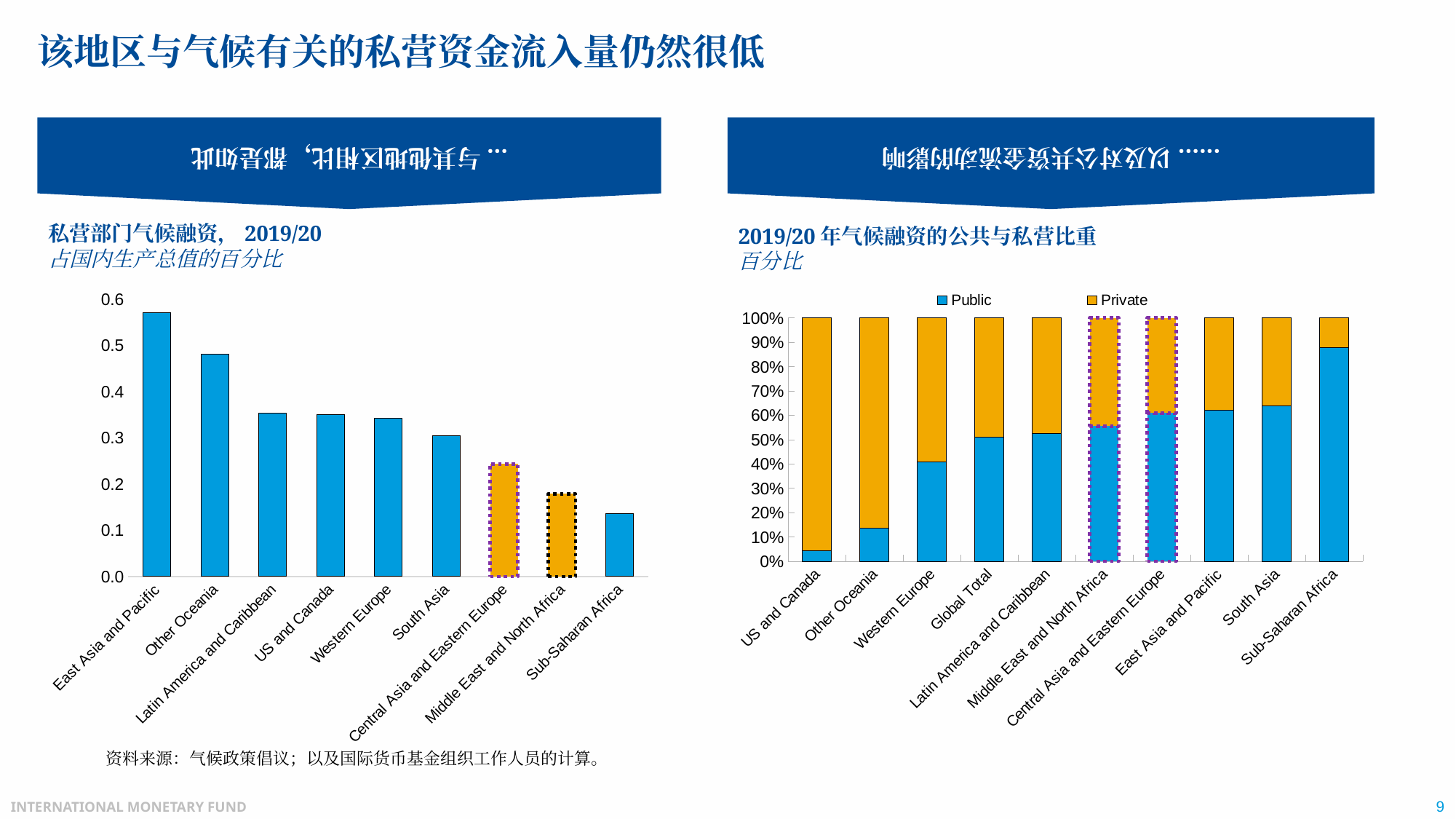
In the left chart (私营部门气候融资，2019/20), which region has the highest value? East Asia and Pacific In the right chart (2019/20 年气候融资的公共与私营比重), how many series does the legend list? 2 In the left chart (私营部门气候融资，2019/20), is the value for Other Oceania greater or less than 0.4? greater In the right chart (2019/20 年气候融资的公共与私营比重), which region has the largest Public share? Sub-Saharan Africa In the right chart (2019/20 年气候融资的公共与私营比重), which colour represents the Private series? orange In the left chart (私营部门气候融资，2019/20), do the values rise or fall from left to right across the regions? fall In the left chart (私营部门气候融资，2019/20), how many regions are shown? 9 What kind of chart is the left chart titled 私营部门气候融资，2019/20? bar chart In the right chart (2019/20 年气候融资的公共与私营比重), how many regions are shown on the x axis? 10 In the left chart (私营部门气候融资，2019/20), which region has the lowest value? Sub-Saharan Africa In the left chart (私营部门气候融资，2019/20), is the value for Middle East and North Africa greater or less than 0.2? less In the right chart (2019/20 年气候融资的公共与私营比重), is the Public share for Western Europe greater or less than 50%? less